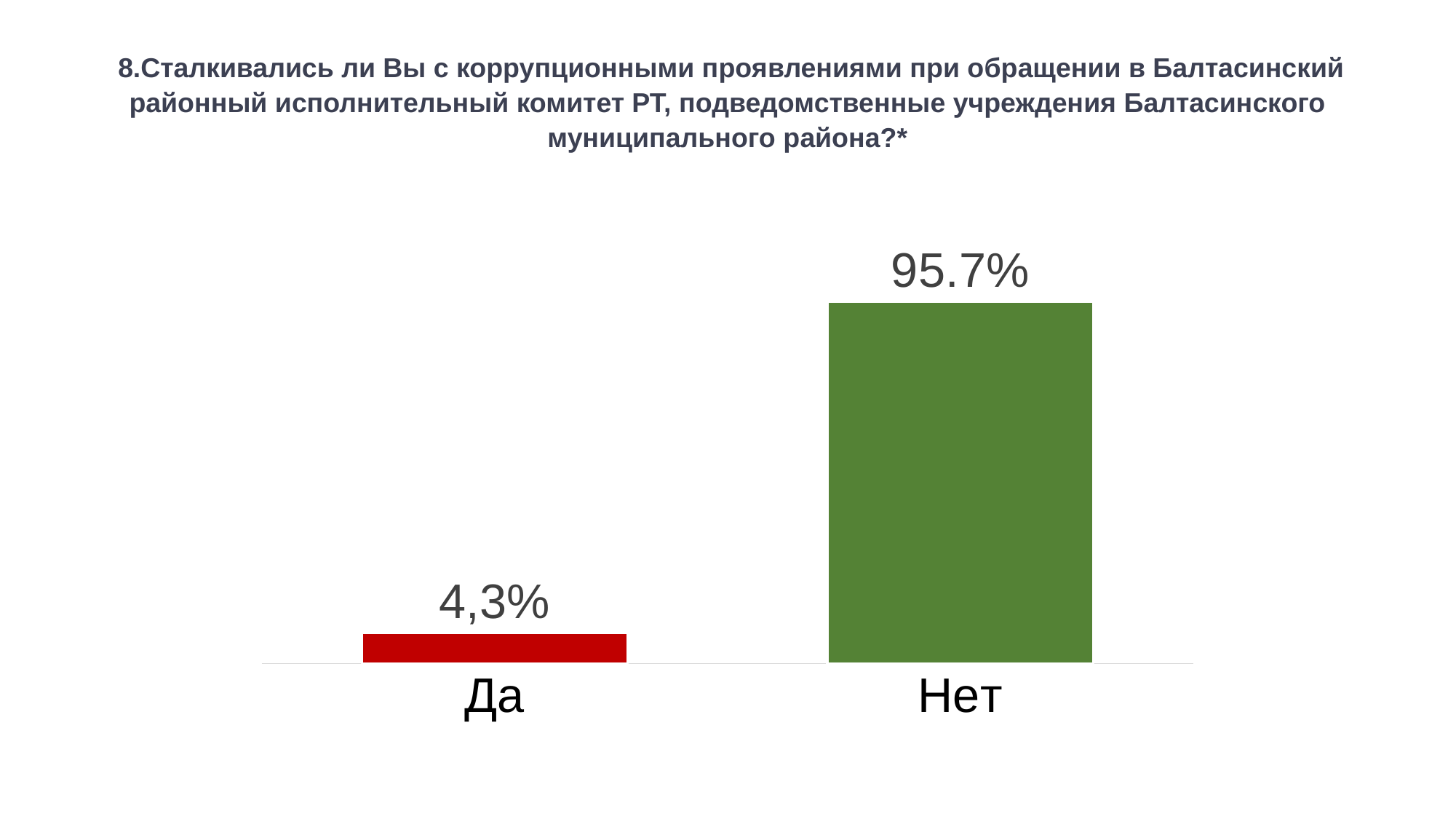
Which is larger, the value for "Да" or the value for "Нет"? Нет What kind of chart is shown on the slide? Bar chart What colour is the bar for "Да"? Red How many categories are shown in the chart? 2 What colour is the bar for "Нет"? Green What is the value for "Да"? 4,3% Which category has the highest value? Нет What is the difference between the values for "Нет" and "Да"? 91.4% What is the value for "Нет"? 95.7% Which category has the lowest value? Да